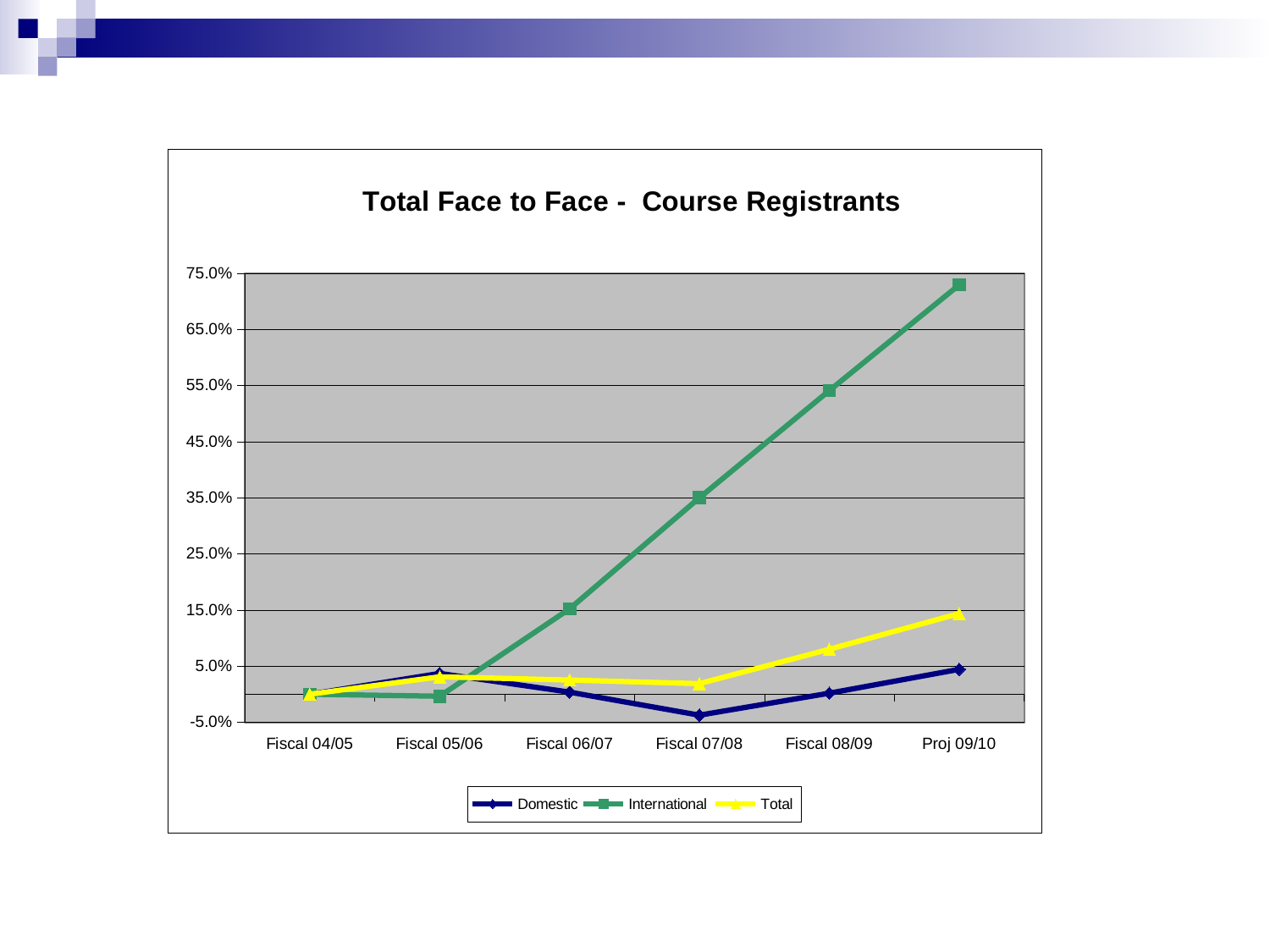
Is the International value for Fiscal 08/09 greater or less than 45.0%? greater What is the title of the chart? Total Face to Face - Course Registrants Which series reaches the highest value on the chart? International In which period does the International series reach its highest value? Proj 09/10 Is the Total value for Proj 09/10 greater or less than 5.0%? greater Does the International series rise or fall from Fiscal 05/06 to Proj 09/10? rise Is the International value for Proj 09/10 greater or less than 65.0%? greater How many fiscal periods are shown on the x axis? 6 How many series does the legend list? 3 At Fiscal 08/09, which is larger: the International value or the Domestic value? International What kind of chart is shown on the slide? line chart